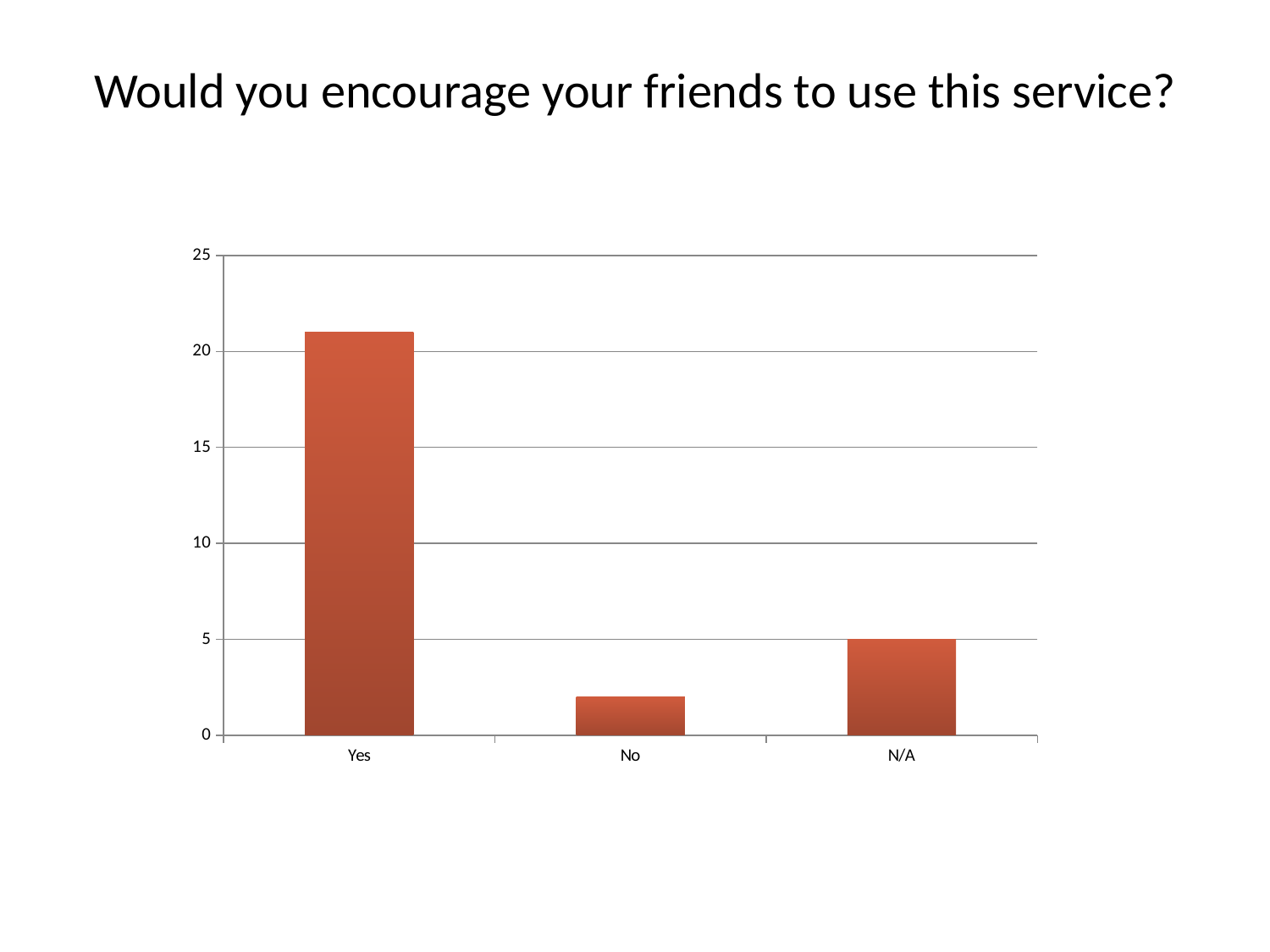
What is the value for N/A? 5 What kind of chart is shown on the slide? bar chart What is the title of the slide above the chart? Would you encourage your friends to use this service? What is the highest value shown on the y axis? 25 Is the value for No greater or less than 5? less Is the value for Yes greater or less than 20? greater Which is larger, the value for Yes or the value for N/A? Yes Which category has the highest value? Yes Which is larger, the value for No or the value for N/A? N/A How many categories are shown on the x axis of the chart? 3 Which category has the lowest value? No